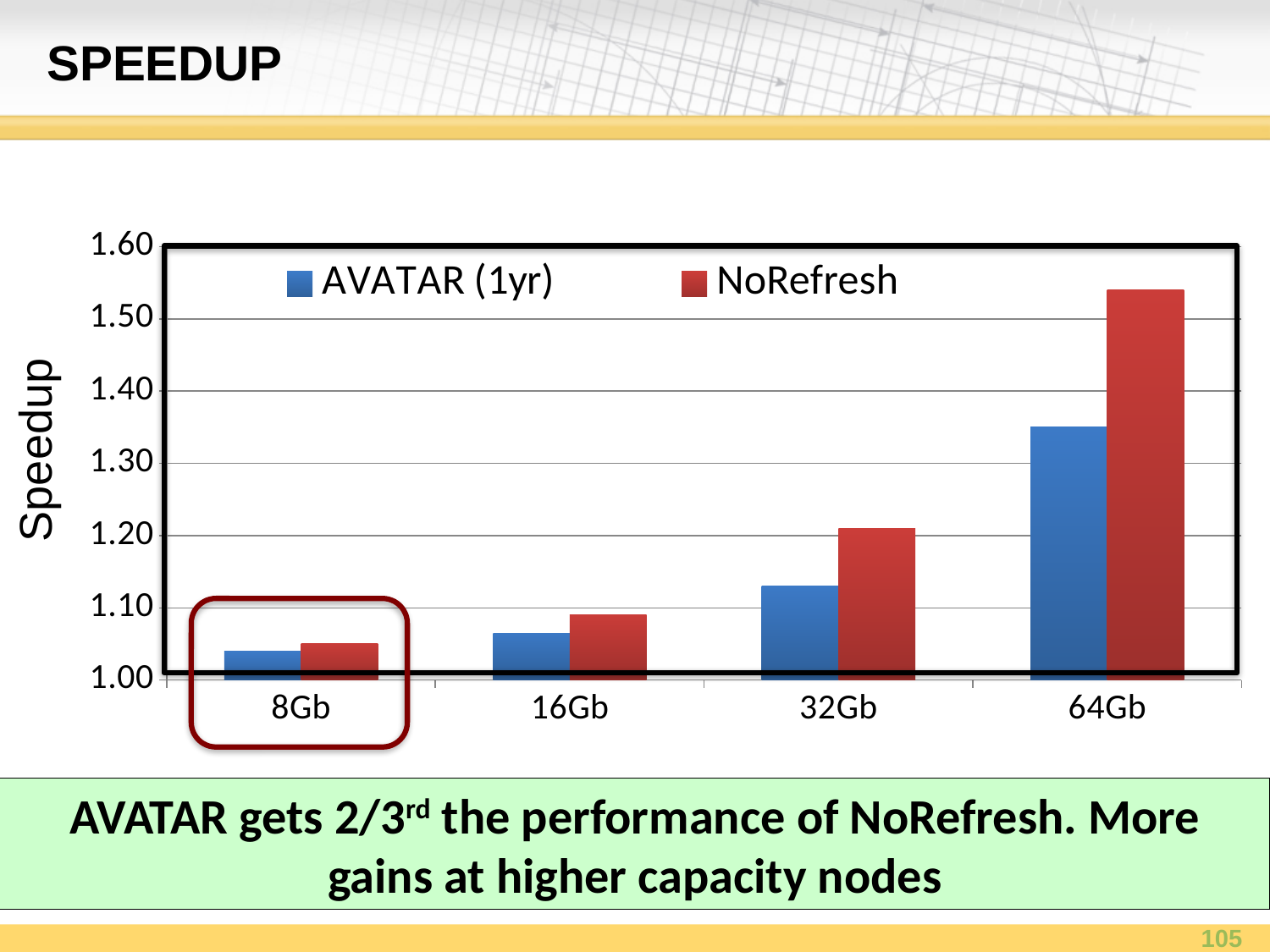
Which capacity has the lowest AVATAR (1yr) speedup? 8Gb Is the NoRefresh speedup for 64Gb greater or less than 1.50? greater How many series does the legend list? 2 Which capacity has the highest NoRefresh speedup? 64Gb What kind of chart is shown on the slide? bar chart At 64Gb, which series has the larger speedup, AVATAR (1yr) or NoRefresh? NoRefresh What is the label on the y axis of the chart? Speedup How many capacity categories are shown on the x axis? 4 Is the AVATAR (1yr) speedup for 8Gb greater or less than 1.10? less Is the AVATAR (1yr) speedup for 64Gb greater or less than 1.40? less Do the NoRefresh speedup values rise or fall as capacity increases from 8Gb to 64Gb? rise